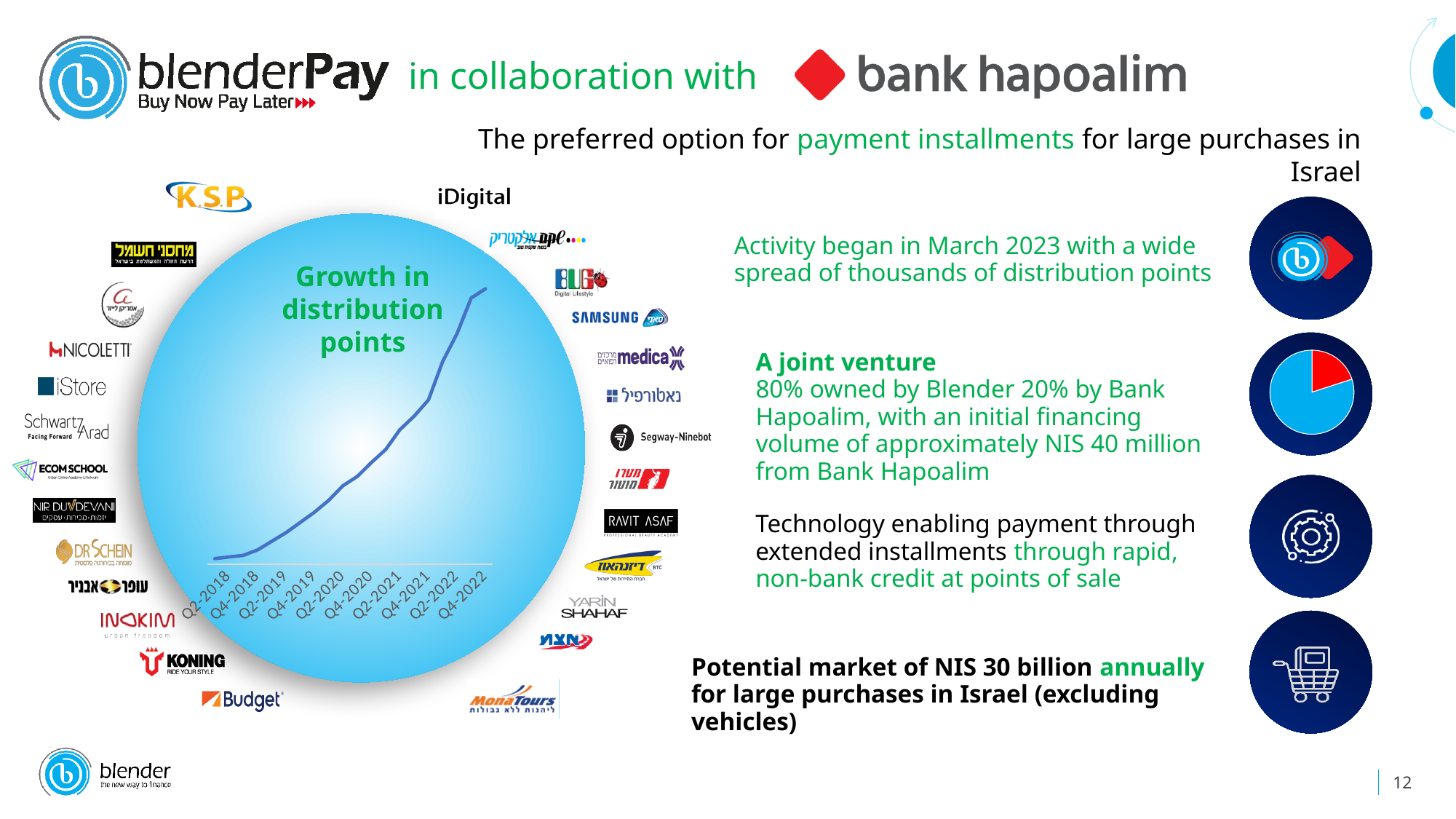
How many lines are plotted in the 'Growth in distribution points' chart? 1 Which quarter has the lowest value in the 'Growth in distribution points' chart? Q2-2018 How many quarter labels are shown on the x axis of the 'Growth in distribution points' chart? 10 Do the values in the 'Growth in distribution points' chart rise or fall from Q2-2018 to Q4-2022? rise Which quarter has the highest value in the 'Growth in distribution points' chart? Q4-2022 In the 'Growth in distribution points' chart, which is larger, the value for Q2-2021 or the value for Q4-2019? Q2-2021 What is the title of the chart inside the blue circle? Growth in distribution points In the 'Growth in distribution points' chart, which is larger, the value for Q4-2018 or the value for Q2-2022? Q2-2022 What kind of chart is shown inside the blue circle on the slide? line chart What is the first quarter label on the x axis of the 'Growth in distribution points' chart? Q2-2018